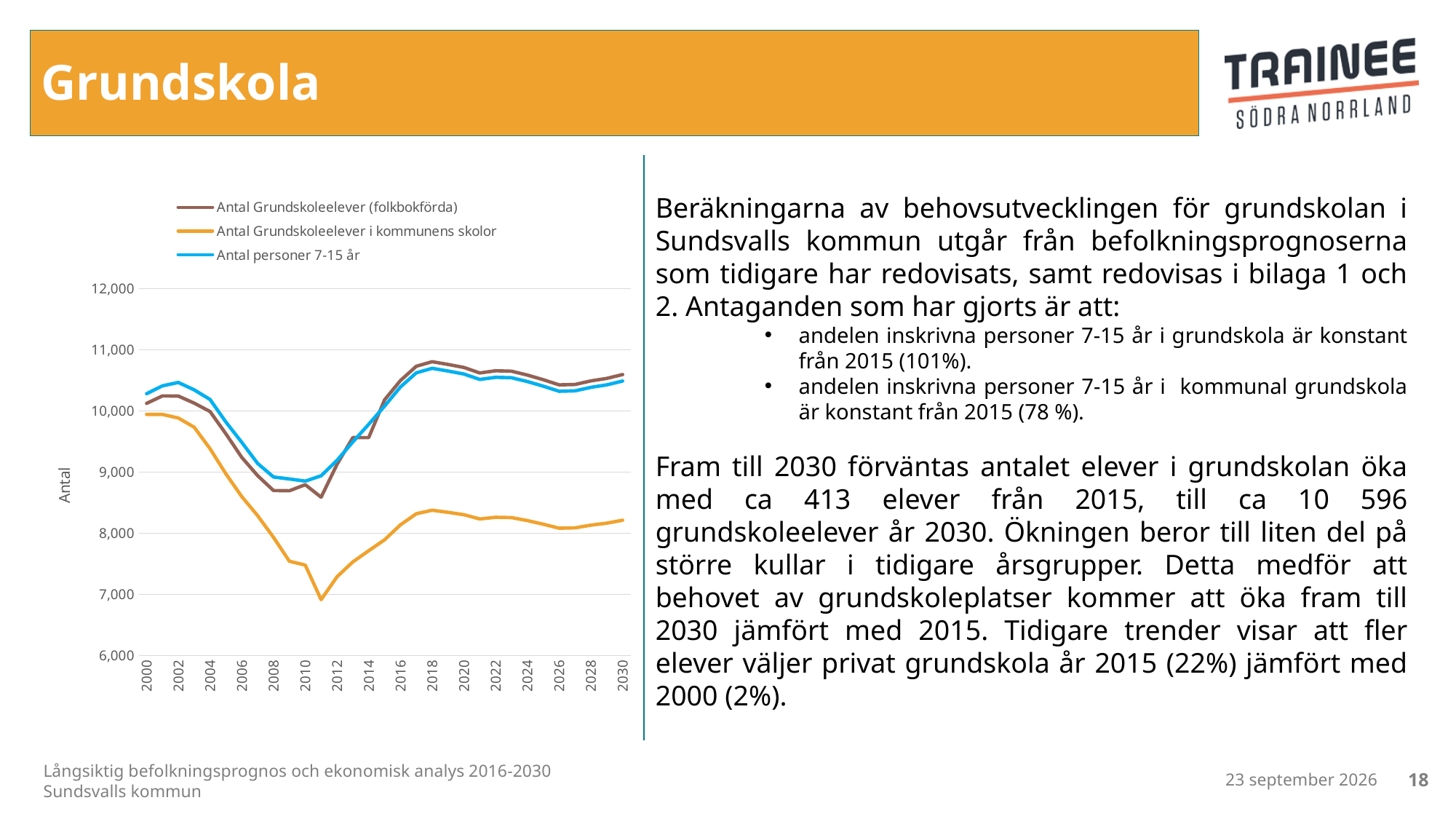
In 2030, which is larger: "Antal Grundskoleelever (folkbokförda)" or "Antal Grundskoleelever i kommunens skolor"? Antal Grundskoleelever (folkbokförda) Is the value for "Antal Grundskoleelever (folkbokförda)" in 2011 greater or less than 9,000? less Which series has the lowest value in 2030? Antal Grundskoleelever i kommunens skolor Is the value for "Antal Grundskoleelever (folkbokförda)" in 2018 greater or less than 10,000? greater Is the value for "Antal Grundskoleelever i kommunens skolor" in 2030 greater or less than 8,000? greater Does "Antal Grundskoleelever i kommunens skolor" rise or fall between 2000 and 2011? fall What is the label on the vertical axis of the chart? Antal Which colour is used for the series "Antal personer 7-15 år"? blue What kind of chart is shown on the slide? line chart In which year does "Antal Grundskoleelever i kommunens skolor" reach its lowest value? 2011 How many series does the chart legend list? 3